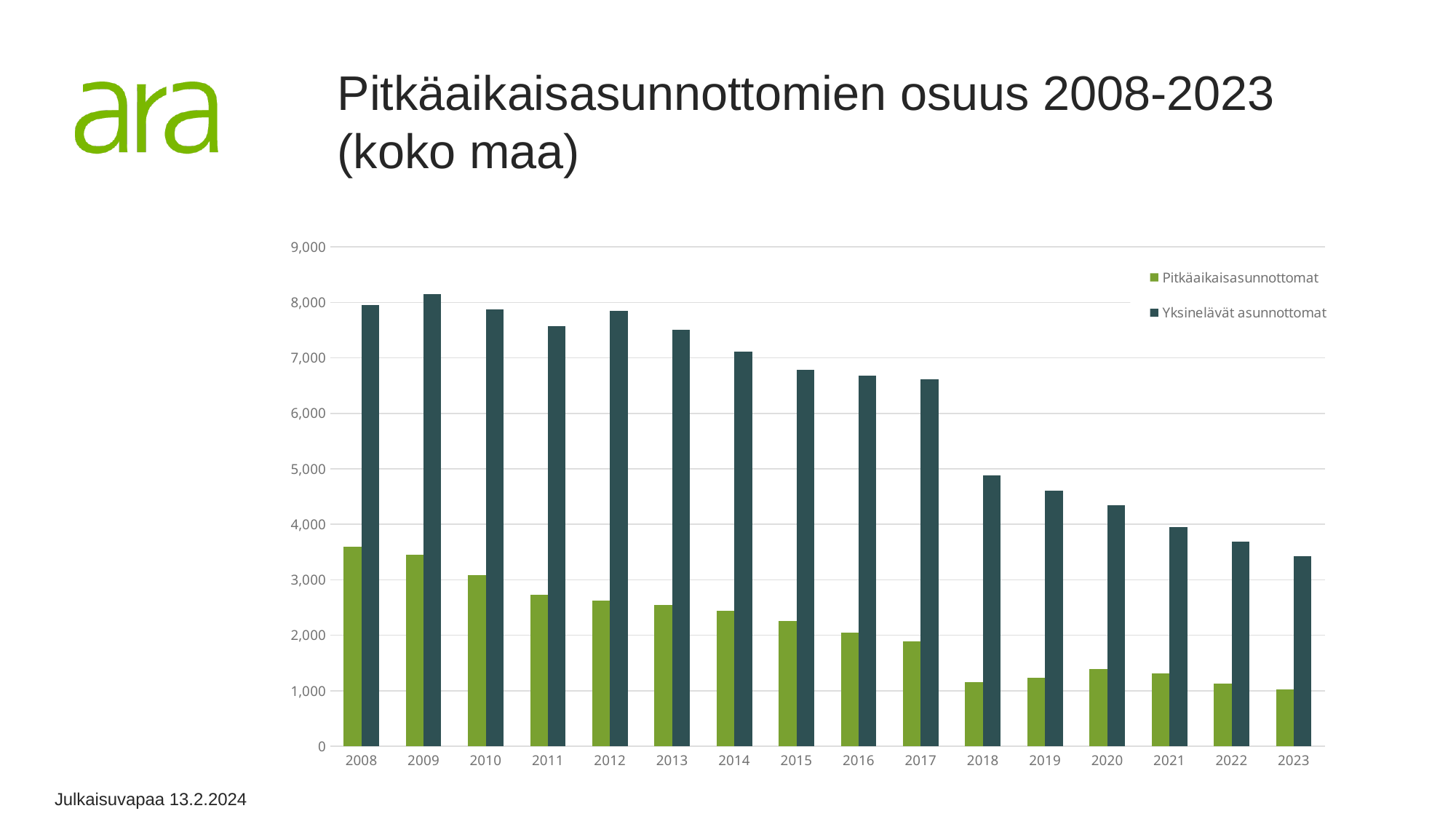
Is the value for Pitkäaikaisasunnottomat in 2020 greater or less than 2,000? less Which is larger: Yksinelävät asunnottomat in 2008 or in 2023? 2008 Is the value for Yksinelävät asunnottomat in 2012 greater or less than 7,000? greater Is the value for Yksinelävät asunnottomat in 2018 greater or less than 5,000? less How many years are shown on the x axis? 16 What kind of chart is shown on the slide? bar chart In which year is the value for Pitkäaikaisasunnottomat highest? 2008 In which year is the value for Yksinelävät asunnottomat highest? 2009 How many series does the legend list? 2 In which year is the value for Yksinelävät asunnottomat lowest? 2023 Do the values for Yksinelävät asunnottomat generally rise or fall from 2008 to 2023? fall